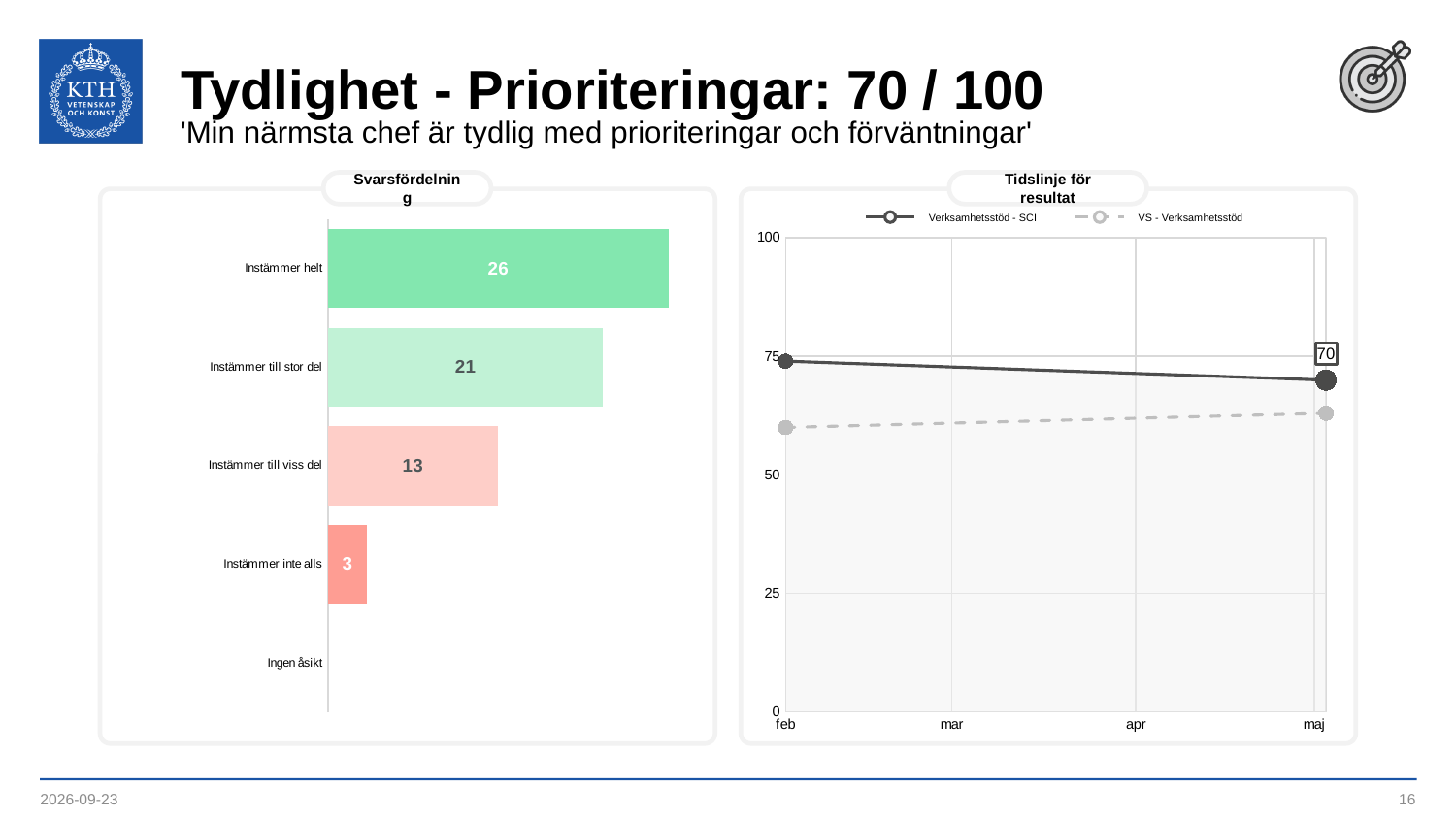
What kind of chart is the 'Tidslinje för resultat' chart? Line chart In the 'Tidslinje för resultat' chart, does the 'Verksamhetsstöd - SCI' line rise or fall from feb to maj? fall In the 'Svarsfördelning' chart, which is larger: 'Instämmer till stor del' or 'Instämmer till viss del'? Instämmer till stor del In the 'Svarsfördelning' chart, what is the value for 'Instämmer till viss del'? 13 In the 'Svarsfördelning' chart, what is the value for 'Instämmer helt'? 26 In the 'Tidslinje för resultat' chart, is the value for 'VS - Verksamhetsstöd' in feb greater or less than 75? less In the 'Svarsfördelning' chart, which category has the highest value? Instämmer helt What kind of chart is the 'Svarsfördelning' chart? Bar chart In the 'Tidslinje för resultat' chart, what is the labelled value for 'Verksamhetsstöd - SCI' in maj? 70 How many series does the legend of the 'Tidslinje för resultat' chart list? 2 How many categories are listed on the axis of the 'Svarsfördelning' chart? 5 In the 'Svarsfördelning' chart, what is the difference between 'Instämmer till stor del' and 'Instämmer inte alls'? 18